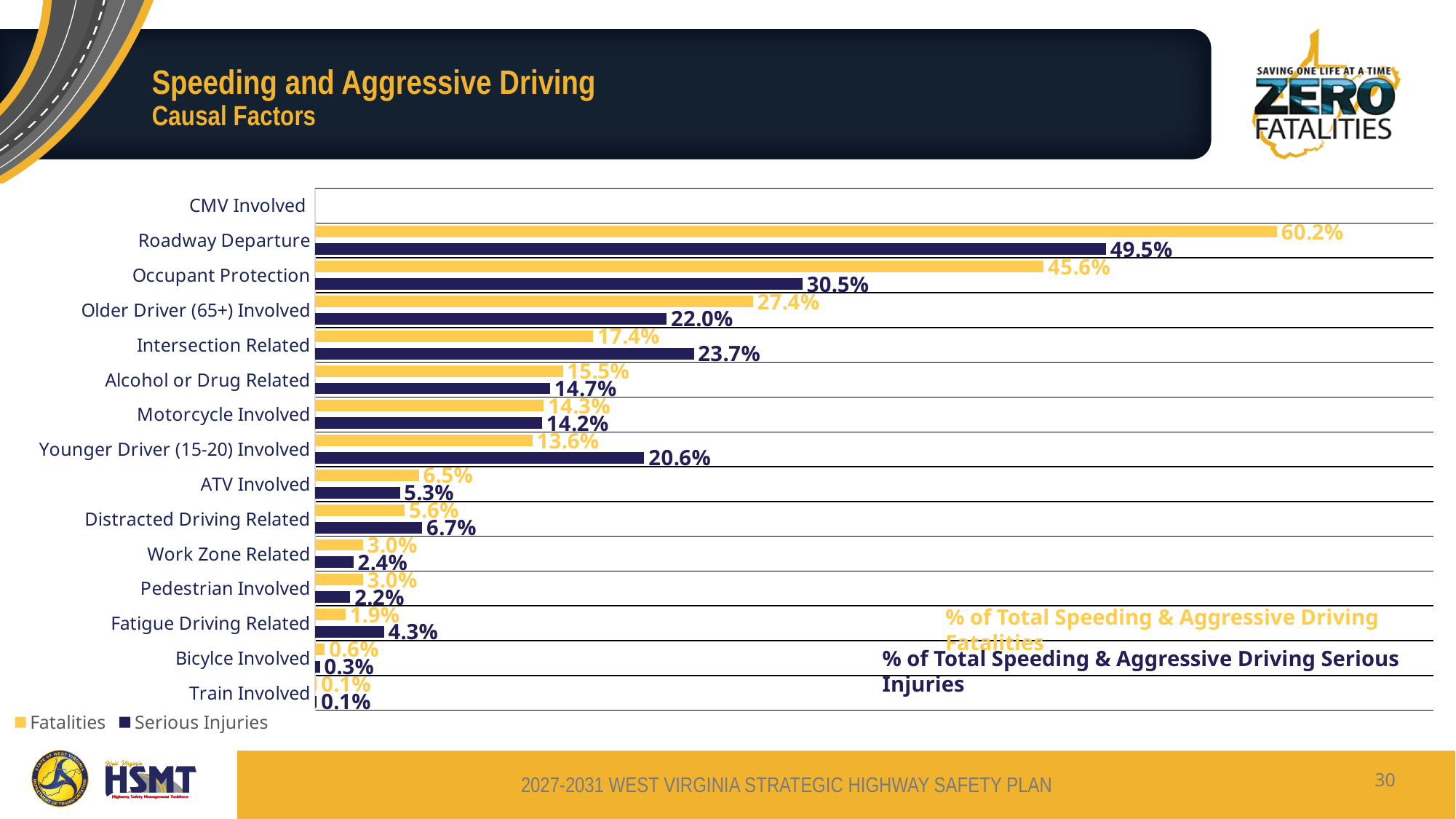
For Intersection Related, which is larger: the Fatalities value or the Serious Injuries value? Serious Injuries Which is larger: the Fatalities value for Occupant Protection or the Fatalities value for Older Driver (65+) Involved? Occupant Protection How many series does the legend list? 2 What is the Fatalities value for Fatigue Driving Related? 1.9% What is the difference between the Fatalities and Serious Injuries values for Roadway Departure? 10.7% Which category has the lowest Serious Injuries value? Train Involved What is the Fatalities value for Roadway Departure? 60.2% What is the Serious Injuries value for Younger Driver (15-20) Involved? 20.6% Which category has the highest Fatalities value? Roadway Departure Which series is shown in yellow in the legend? Fatalities What is the Serious Injuries value for Occupant Protection? 30.5% What kind of chart is shown on the slide? bar chart